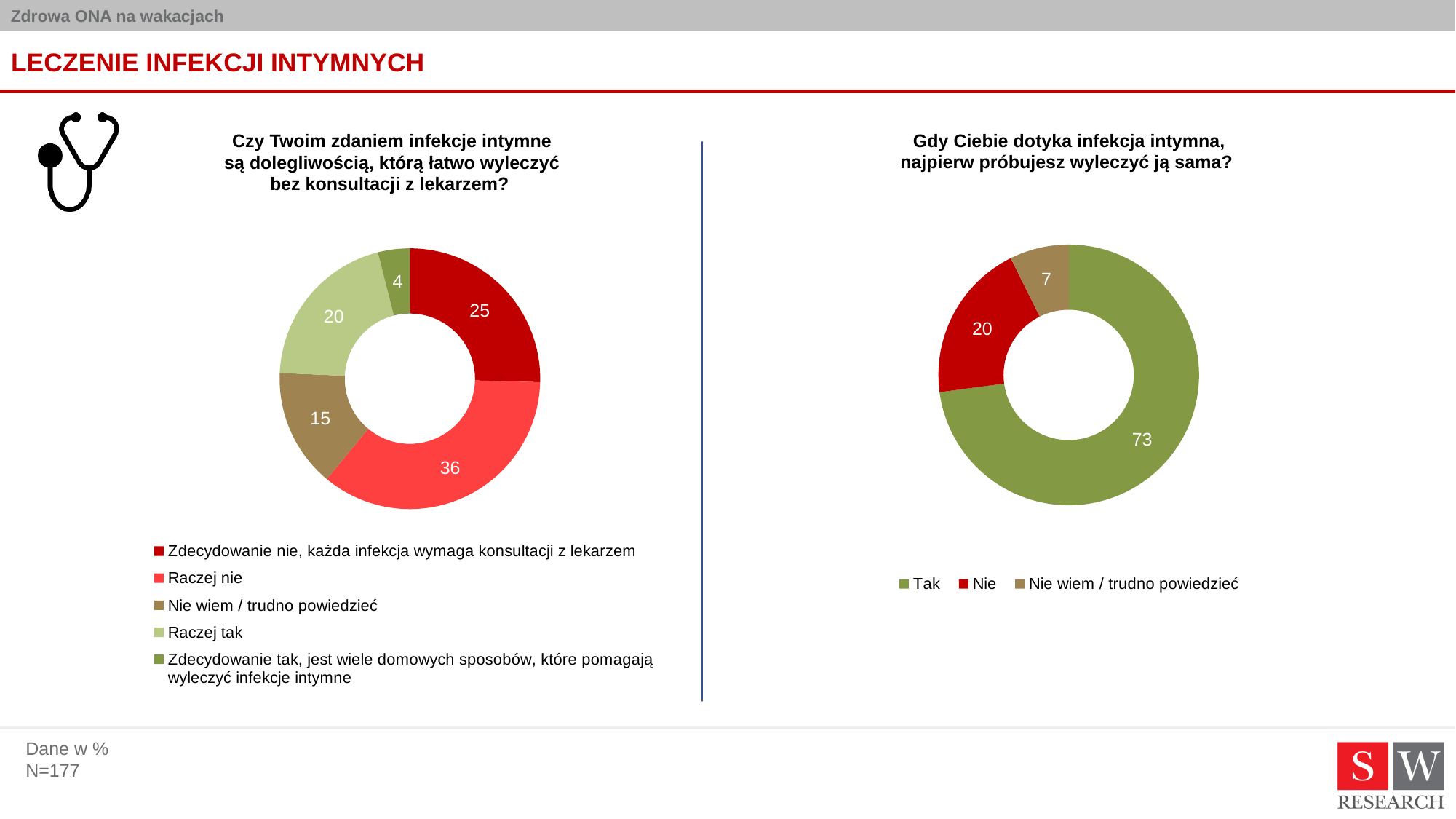
How many categories does the left chart show? 5 In the right chart, what is the difference between "Tak" and "Nie"? 53 What kind of chart is the right chart? Doughnut (pie) chart In the left chart, which category has the highest value? Raczej nie How many entries does the legend of the right chart list? 3 In the left chart ("Czy Twoim zdaniem infekcje intymne są dolegliwością, którą łatwo wyleczyć bez konsultacji z lekarzem?"), what is the value for "Raczej nie"? 36 In the left chart, what is the difference between "Raczej nie" and "Zdecydowanie nie, każda infekcja wymaga konsultacji z lekarzem"? 11 In the left chart, what is the value for "Zdecydowanie tak, jest wiele domowych sposobów, które pomagają wyleczyć infekcje intymne"? 4 In the left chart, which category has the lowest value? Zdecydowanie tak, jest wiele domowych sposobów, które pomagają wyleczyć infekcje intymne In the right chart ("Gdy Ciebie dotyka infekcja intymna, najpierw próbujesz wyleczyć ją sama?"), what is the value for "Tak"? 73 In the right chart, what is the value for "Nie wiem / trudno powiedzieć"? 7 In the left chart, which is larger: "Raczej tak" or "Nie wiem / trudno powiedzieć"? Raczej tak